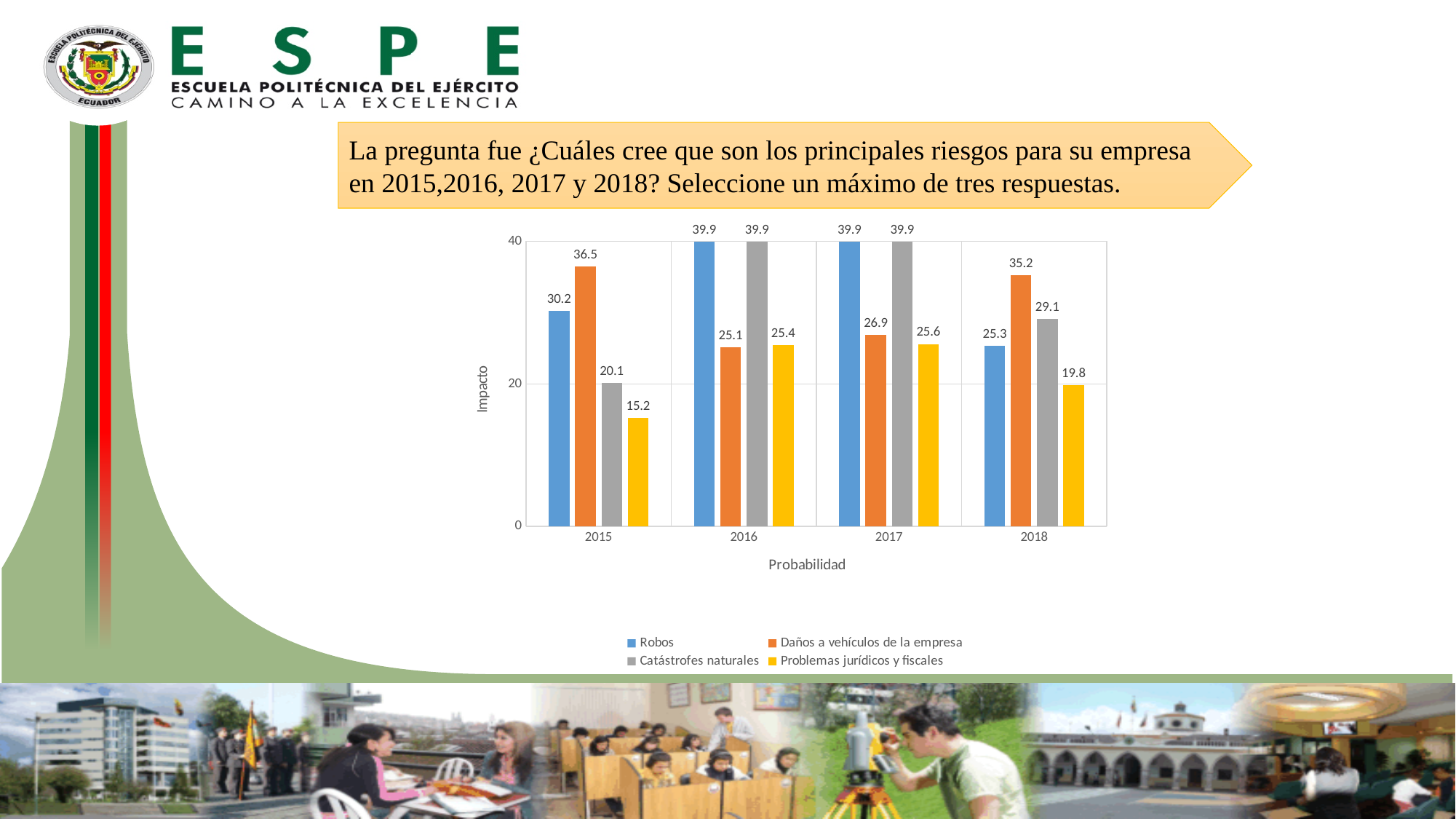
What kind of chart is shown on the slide? Bar chart What is the value for Robos in 2015? 30.2 In which year is the value for Daños a vehículos de la empresa highest? 2015 Which is larger in 2015: the value for Robos or the value for Catástrofes naturales? Robos How many years are shown on the x axis? 4 How many series does the legend list? 4 What is the difference between the Daños a vehículos de la empresa value and the Robos value in 2018? 9.9 What is the value for Daños a vehículos de la empresa in 2017? 26.9 What is the value for Problemas jurídicos y fiscales in 2018? 19.8 In which year is the value for Problemas jurídicos y fiscales lowest? 2015 What is the label of the y axis? Impacto What is the value for Catástrofes naturales in 2016? 39.9